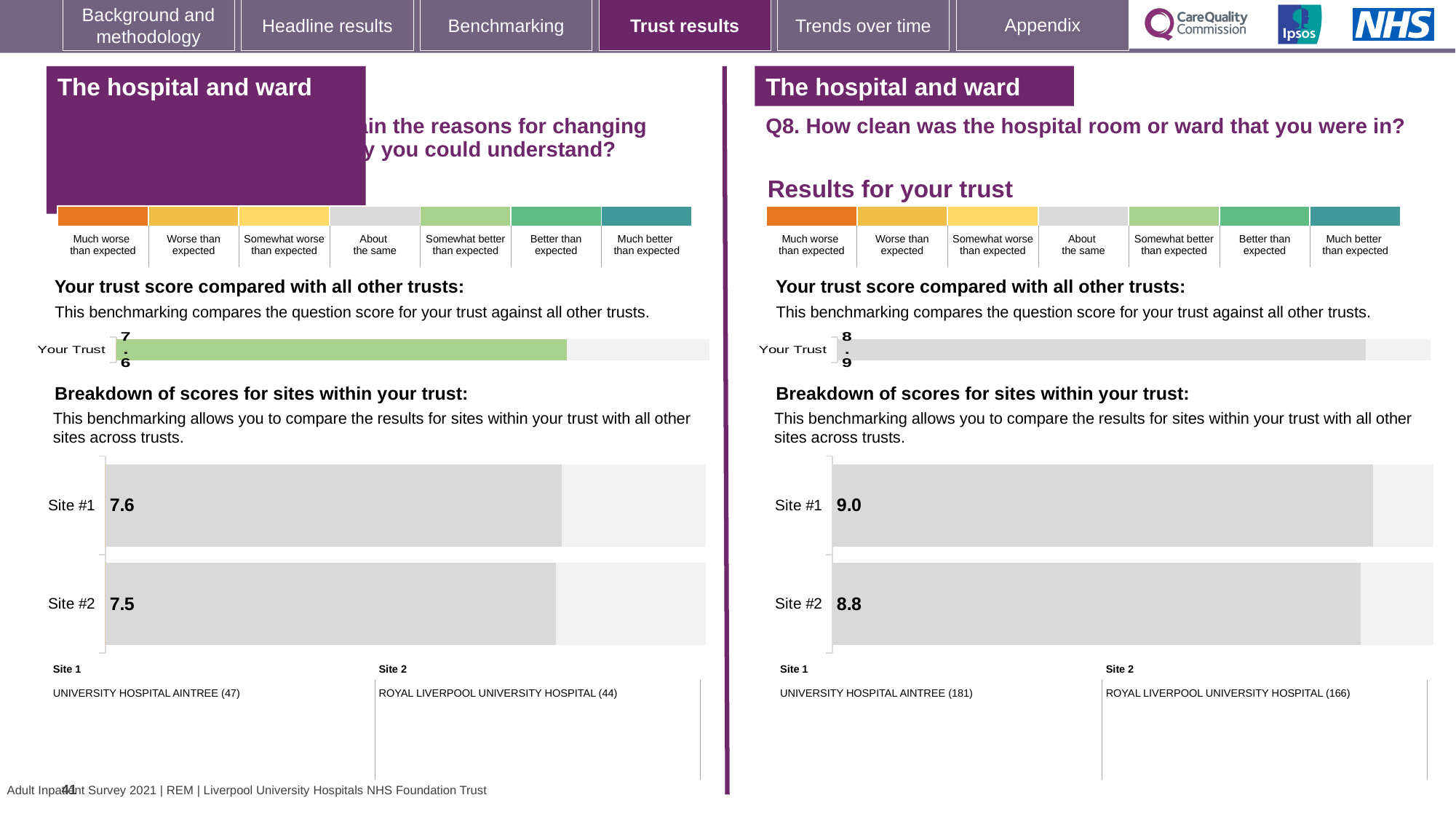
On the right-hand chart for Q8 (How clean was the hospital room or ward that you were in?), what is the trust score shown for 'Your Trust'? 8.9 On the left-hand chart, what is the difference between the Site #1 and Site #2 scores? 0.1 On the right-hand chart for Q8, what is the difference between the Site #1 and Site #2 scores? 0.2 On the right-hand chart for Q8, what is the score for Site #1? 9.0 On the right-hand side for Q8, which hospital is listed as Site 1? UNIVERSITY HOSPITAL AINTREE (181) On the right-hand chart for Q8, which site has the higher score, Site #1 or Site #2? Site #1 What type of chart is used to show the breakdown of scores for sites within the trust? Bar chart How many sites are shown in the site breakdown chart on the right-hand side for Q8? 2 On the left-hand chart, what is the score for Site #2? 7.5 On the left-hand chart, what is the trust score shown for 'Your Trust'? 7.6 On the left-hand chart, what is the score for Site #1? 7.6 On the right-hand chart for Q8, what is the score for Site #2? 8.8